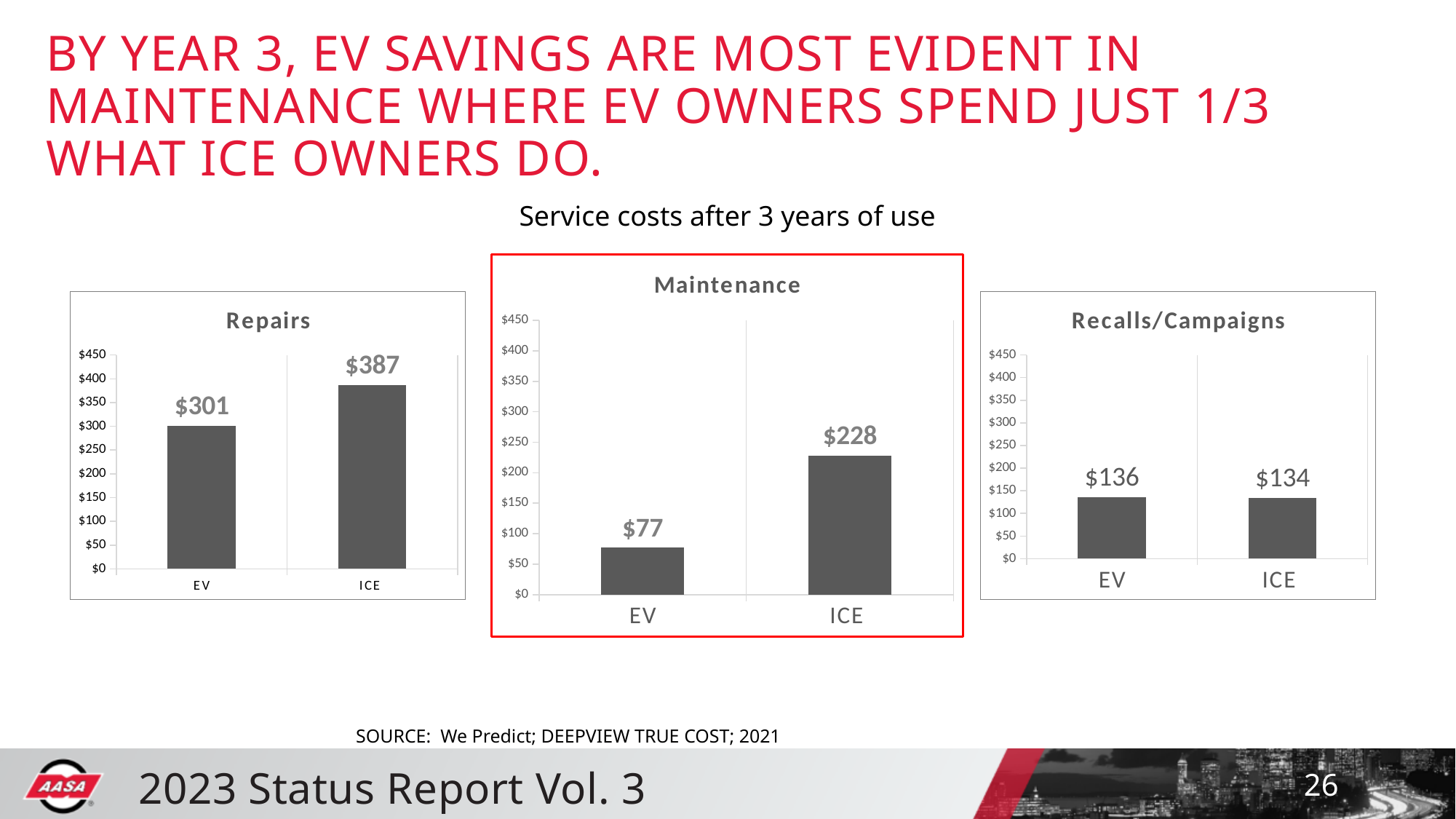
In the Maintenance chart, what is the value for EV? $77 In the Maintenance chart, what is the value for ICE? $228 In the Maintenance chart, is the value for EV greater or less than $100? less In the Repairs chart, which category has the lowest value? EV In the Maintenance chart, what is the difference between the ICE and EV values? $151 In the Maintenance chart, which category has the higher value, EV or ICE? ICE In the Repairs chart, what is the value for ICE? $387 In the Repairs chart, what is the value for EV? $301 In the Recalls/Campaigns chart, what is the value for EV? $136 What kind of chart is the Maintenance chart? bar chart How many categories does the Recalls/Campaigns chart show? 2 In the Repairs chart, what is the difference between the ICE and EV values? $86